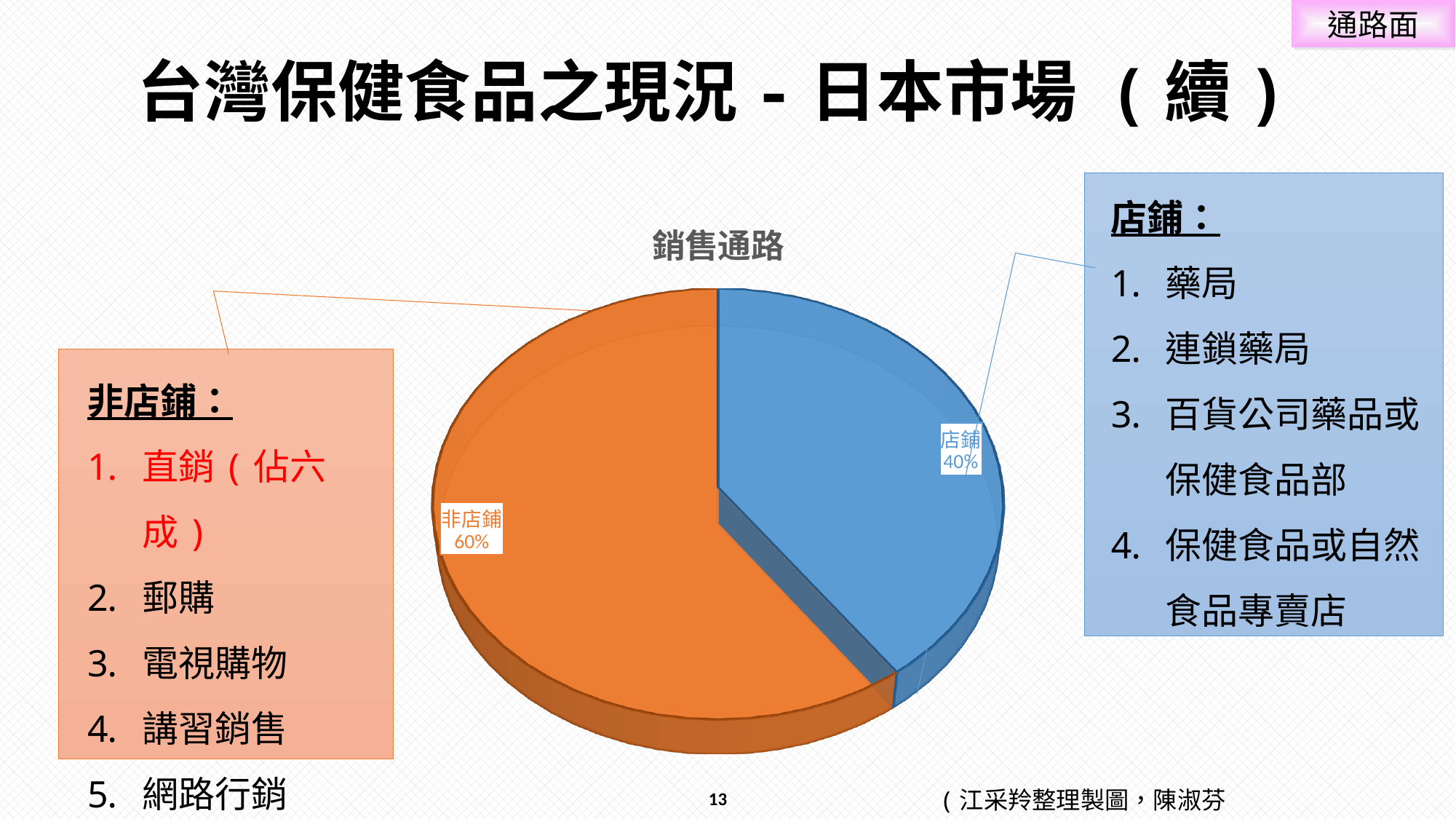
What type of chart is shown on the slide? pie chart What share of the pie does 店鋪 hold? 40% What is the title of the chart? 銷售通路 What colour is the 店鋪 slice of the pie? blue What share of the pie does 非店鋪 hold? 60% Is the share for 店鋪 greater or less than 50%? less What is the difference in percentage points between 非店鋪 and 店鋪? 20% How many slices does the pie chart have? 2 Which slice of the pie is the smallest? 店鋪 Which slice of the pie is the largest? 非店鋪 Which is larger, the share for 非店鋪 or the share for 店鋪? 非店鋪